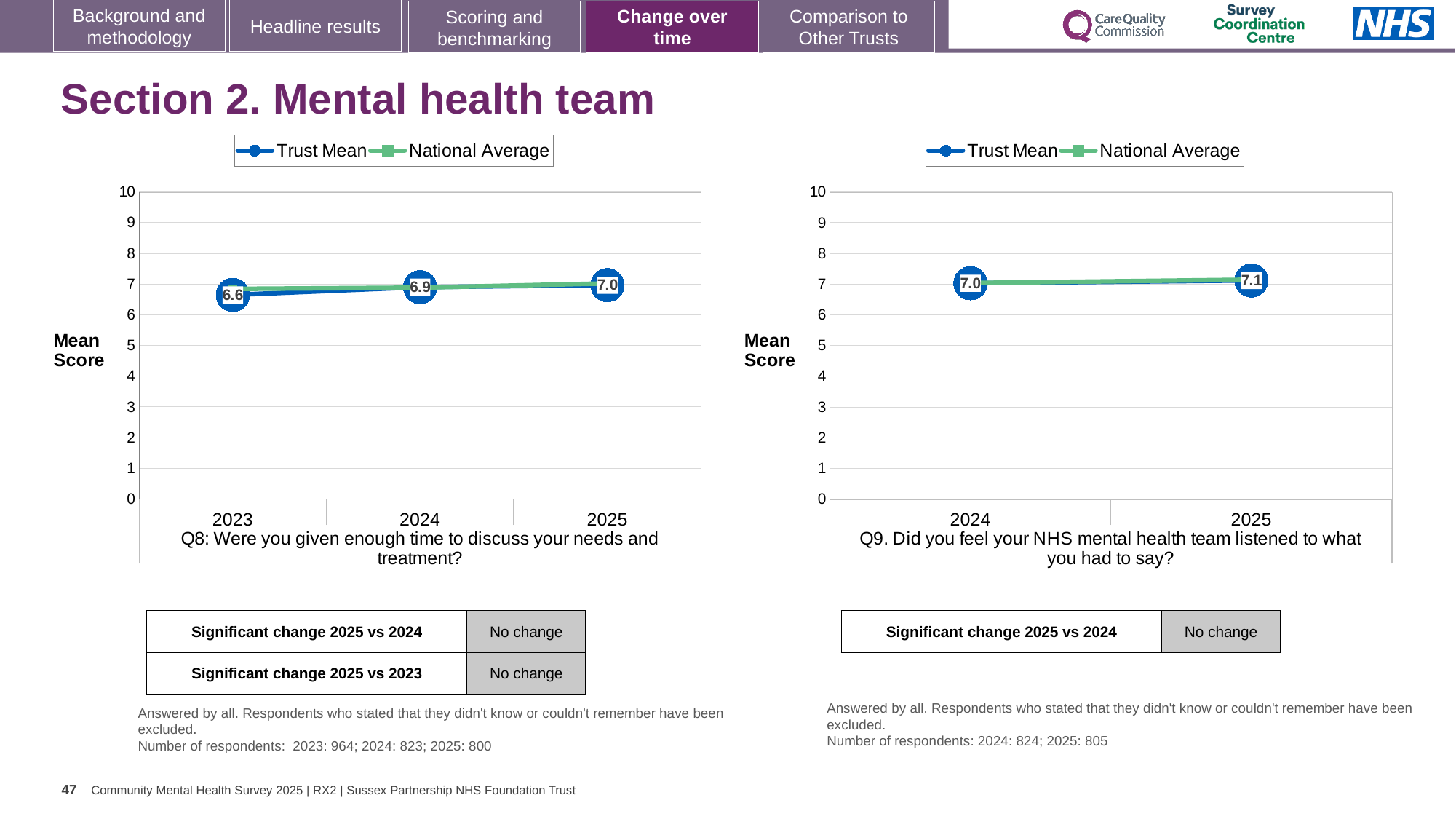
In the right chart (Q9), is the National Average for 2025 greater or less than 5? greater How many series does the legend of the left chart (Q8) list? 2 What kind of chart is the right chart (Q9)? line chart In the left chart (Q8), what is the Trust Mean for 2025? 7.0 In the right chart (Q9), what is the Trust Mean for 2025? 7.1 How many years are plotted in the right chart (Q9)? 2 In the left chart (Q8), which year has the highest Trust Mean? 2025 In the left chart (Q8), which year has the lowest Trust Mean? 2023 In the left chart (Q8), what is the difference between the Trust Mean for 2025 and 2023? 0.4 In the left chart (Q8), what is the Trust Mean for 2023? 6.6 In the right chart (Q9), what is the Trust Mean for 2024? 7.0 In the left chart (Q8), does the Trust Mean rise or fall from 2023 to 2025? rise